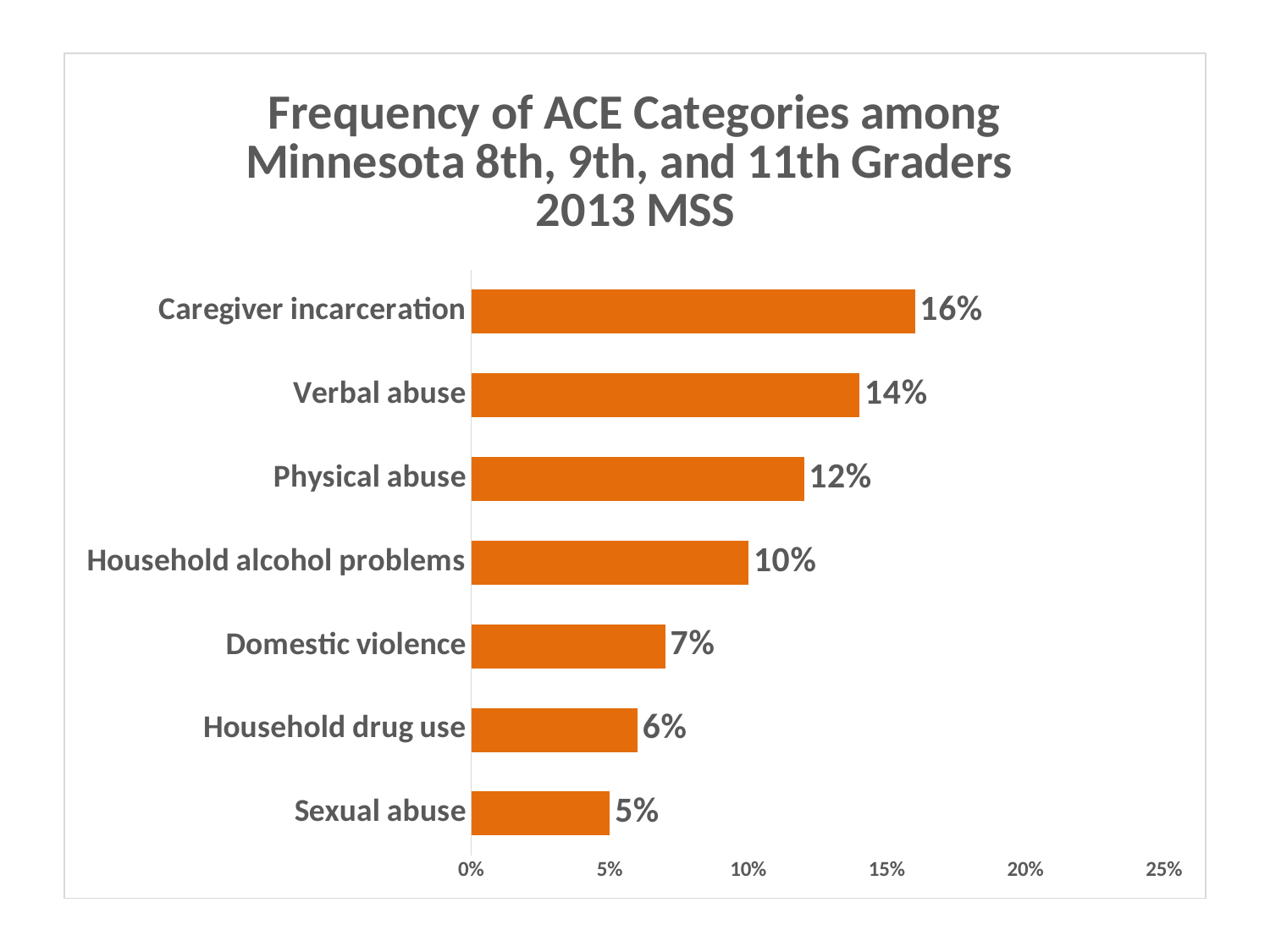
How many categories are shown in the chart? 7 Is the value for Physical abuse greater or less than 10%? greater What is the value for Household alcohol problems? 10% What kind of chart is shown on the slide? Bar chart What is the difference between the values for Verbal abuse and Physical abuse? 2% Which category has the lowest value? Sexual abuse What is the title of the chart? Frequency of ACE Categories among Minnesota 8th, 9th, and 11th Graders 2013 MSS What is the difference between the values for Caregiver incarceration and Sexual abuse? 11% What is the value for Sexual abuse? 5% What is the value for Caregiver incarceration? 16% Which is larger, the value for Domestic violence or the value for Household drug use? Domestic violence Which category has the highest value? Caregiver incarceration